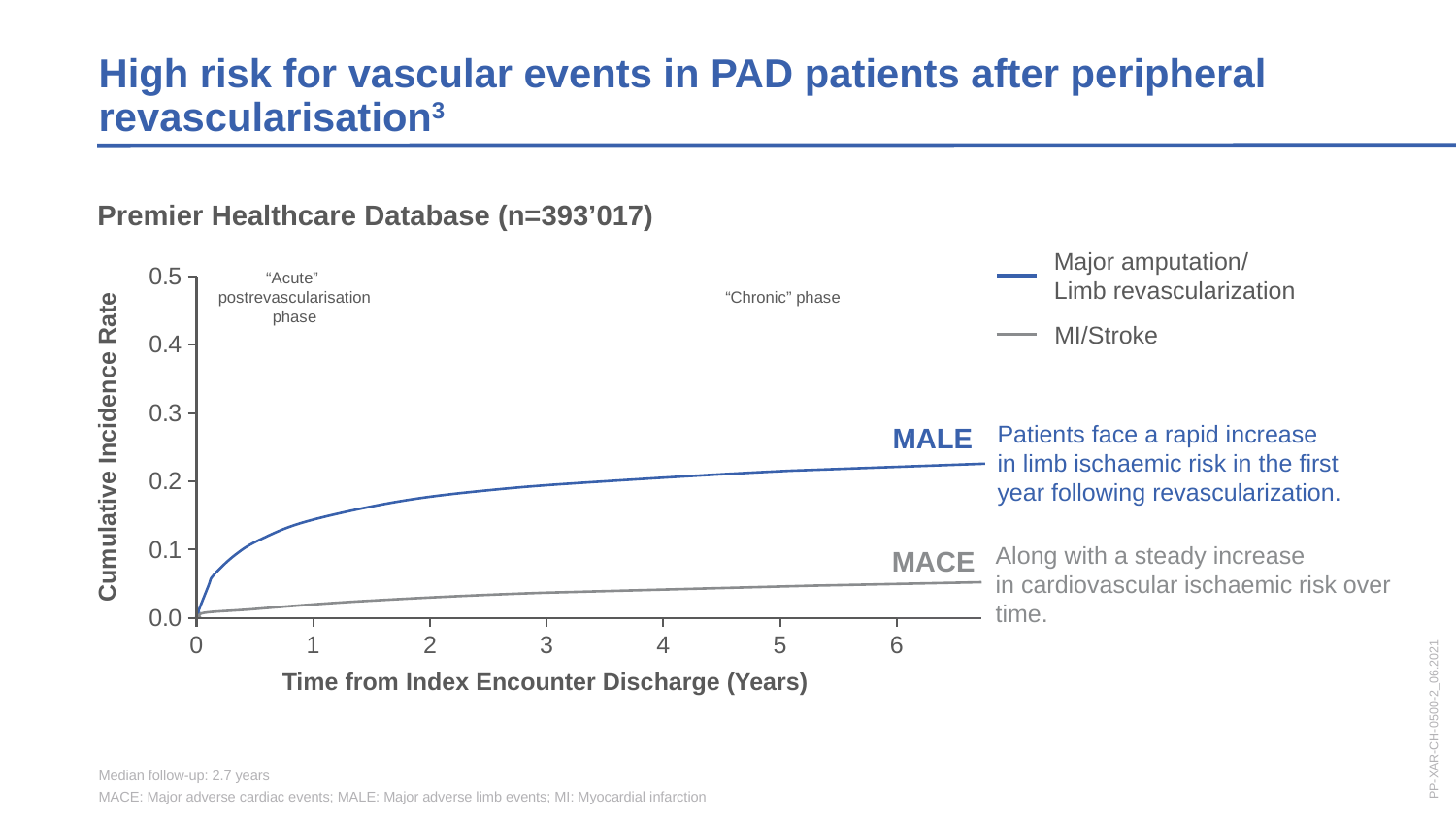
What is the label of the y axis? Cumulative Incidence Rate Does the MI/Stroke curve rise or fall over time? rise How many series does the legend list? 2 Is the cumulative incidence rate for Major amputation/Limb revascularization at 1 year greater or less than 0.1? greater Is the cumulative incidence rate for Major amputation/Limb revascularization at 6 years greater or less than 0.2? greater Which series is higher at 6 years from index encounter discharge: Major amputation/Limb revascularization or MI/Stroke? Major amputation/Limb revascularization What kind of chart is shown on the slide? line chart Is the cumulative incidence rate for MI/Stroke at 6 years greater or less than 0.1? less Does the Major amputation/Limb revascularization curve rise or fall as time from index encounter discharge increases? rise What colour is the line for Major amputation/Limb revascularization? blue